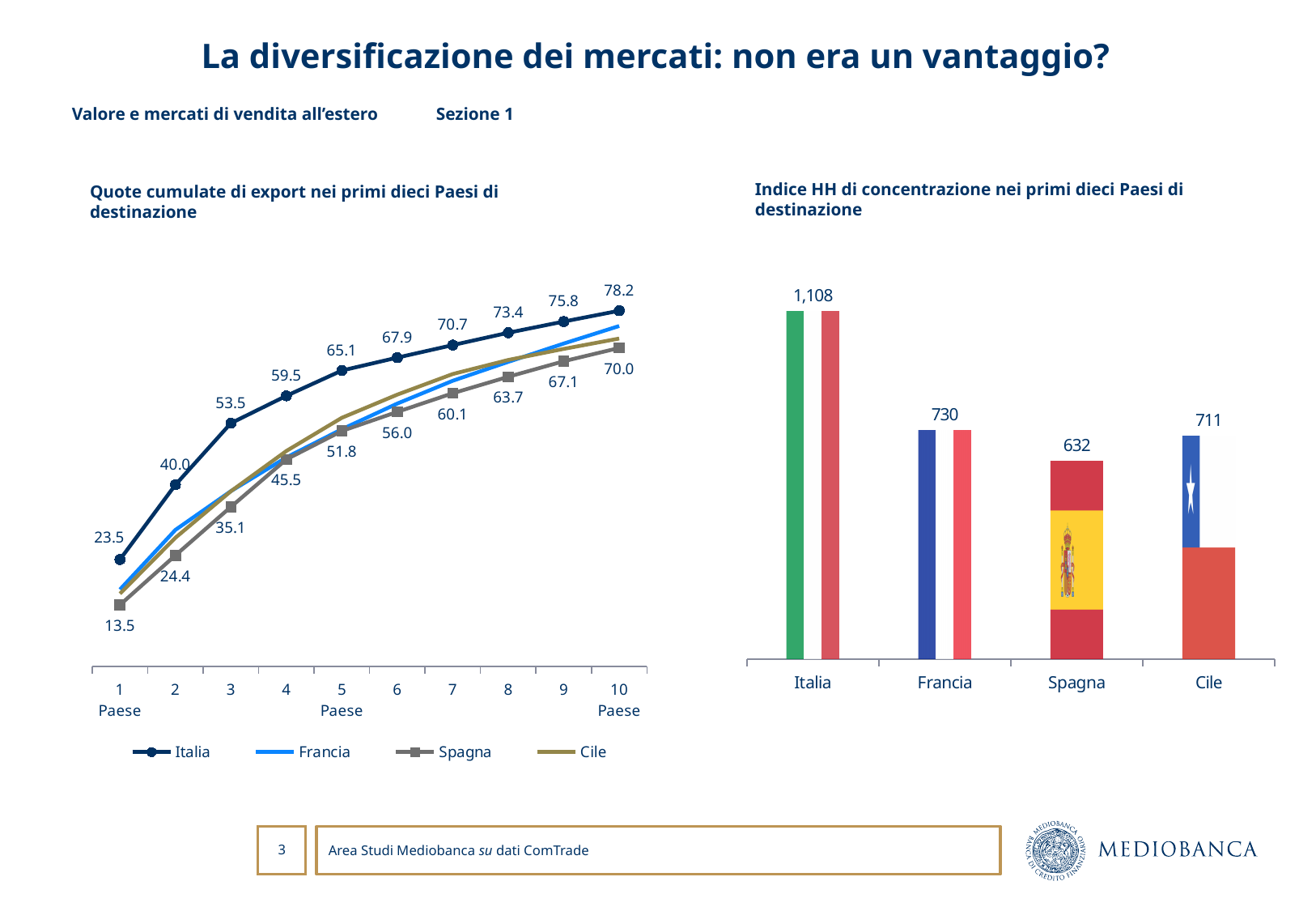
In the chart 'Indice HH di concentrazione nei primi dieci Paesi di destinazione', how many countries are shown? 4 In the chart 'Quote cumulate di export nei primi dieci Paesi di destinazione', what is the difference between Italia and Spagna at Paese 5? 13.3 In the chart 'Indice HH di concentrazione nei primi dieci Paesi di destinazione', what is the value for Italia? 1,108 In the chart 'Quote cumulate di export nei primi dieci Paesi di destinazione', does the Italia line rise or fall from Paese 1 to Paese 10? Rises In the chart 'Quote cumulate di export nei primi dieci Paesi di destinazione', what is the value for Italia at Paese 1? 23.5 In the chart 'Indice HH di concentrazione nei primi dieci Paesi di destinazione', which country has the lowest value? Spagna What kind of chart is 'Indice HH di concentrazione nei primi dieci Paesi di destinazione'? Bar chart In the chart 'Quote cumulate di export nei primi dieci Paesi di destinazione', which is larger at Paese 3, Italia or Spagna? Italia In the chart 'Indice HH di concentrazione nei primi dieci Paesi di destinazione', which country has the highest value? Italia In the chart 'Indice HH di concentrazione nei primi dieci Paesi di destinazione', what is the difference between the values for Francia and Cile? 19 In the chart 'Quote cumulate di export nei primi dieci Paesi di destinazione', what is the value for Spagna at Paese 10? 70.0 How many series does the legend of the chart 'Quote cumulate di export nei primi dieci Paesi di destinazione' list? 4